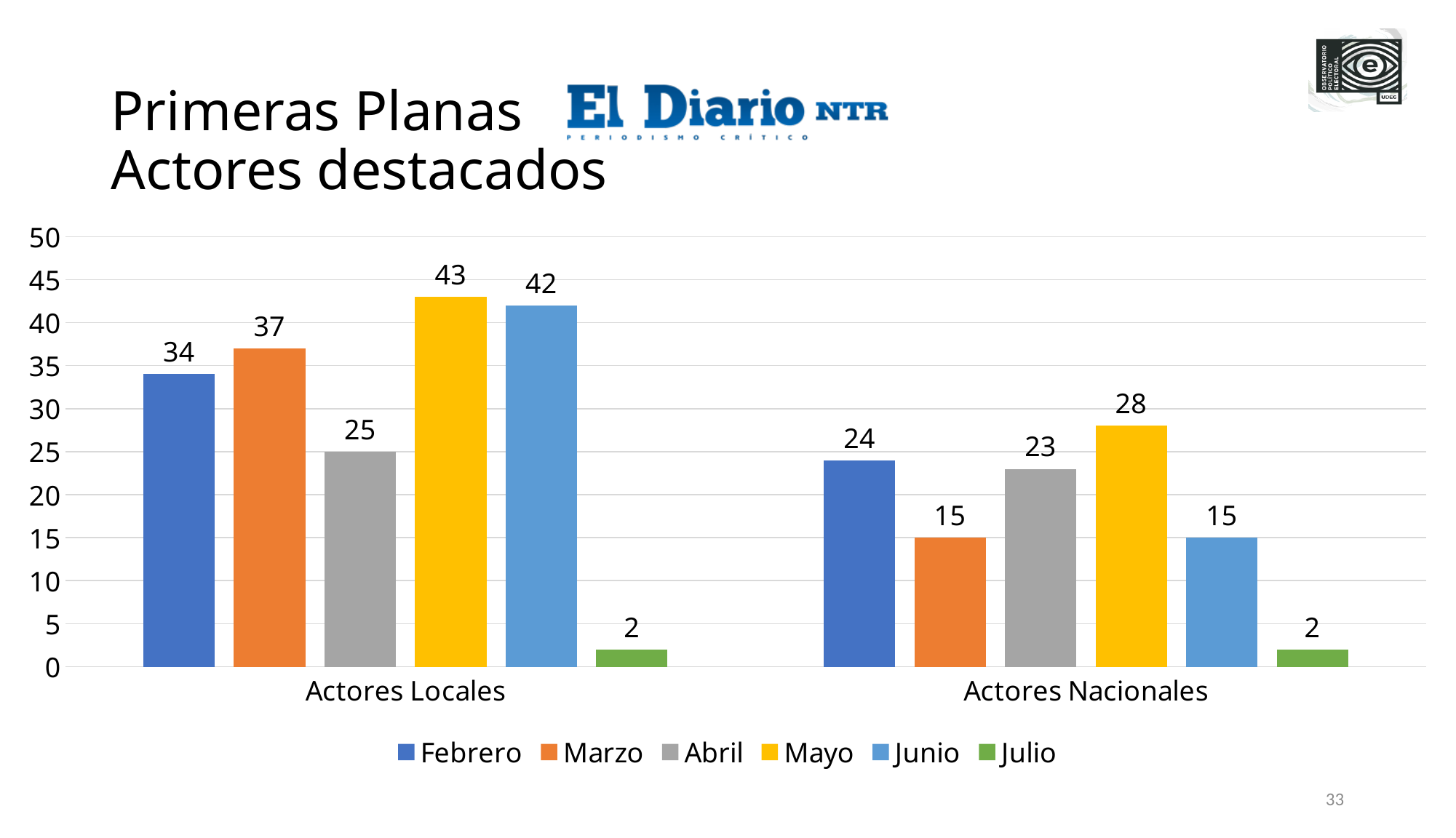
What is the value for Abril in the Actores Locales group? 25 Which is larger: the Junio value for Actores Locales or the Junio value for Actores Nacionales? Actores Locales What is the value for Mayo in the Actores Locales group? 43 What is the difference between the Mayo and Abril values in the Actores Nacionales group? 5 How many categories are shown on the x axis? 2 Which month has the lowest value in the Actores Locales group? Julio What is the difference between the Febrero values for Actores Locales and Actores Nacionales? 10 What is the value for Marzo in the Actores Nacionales group? 15 Which month has the highest value in the Actores Nacionales group? Mayo What kind of chart is shown on the slide? Bar chart How many series does the legend list? 6 Which colour represents Julio in the legend? Green